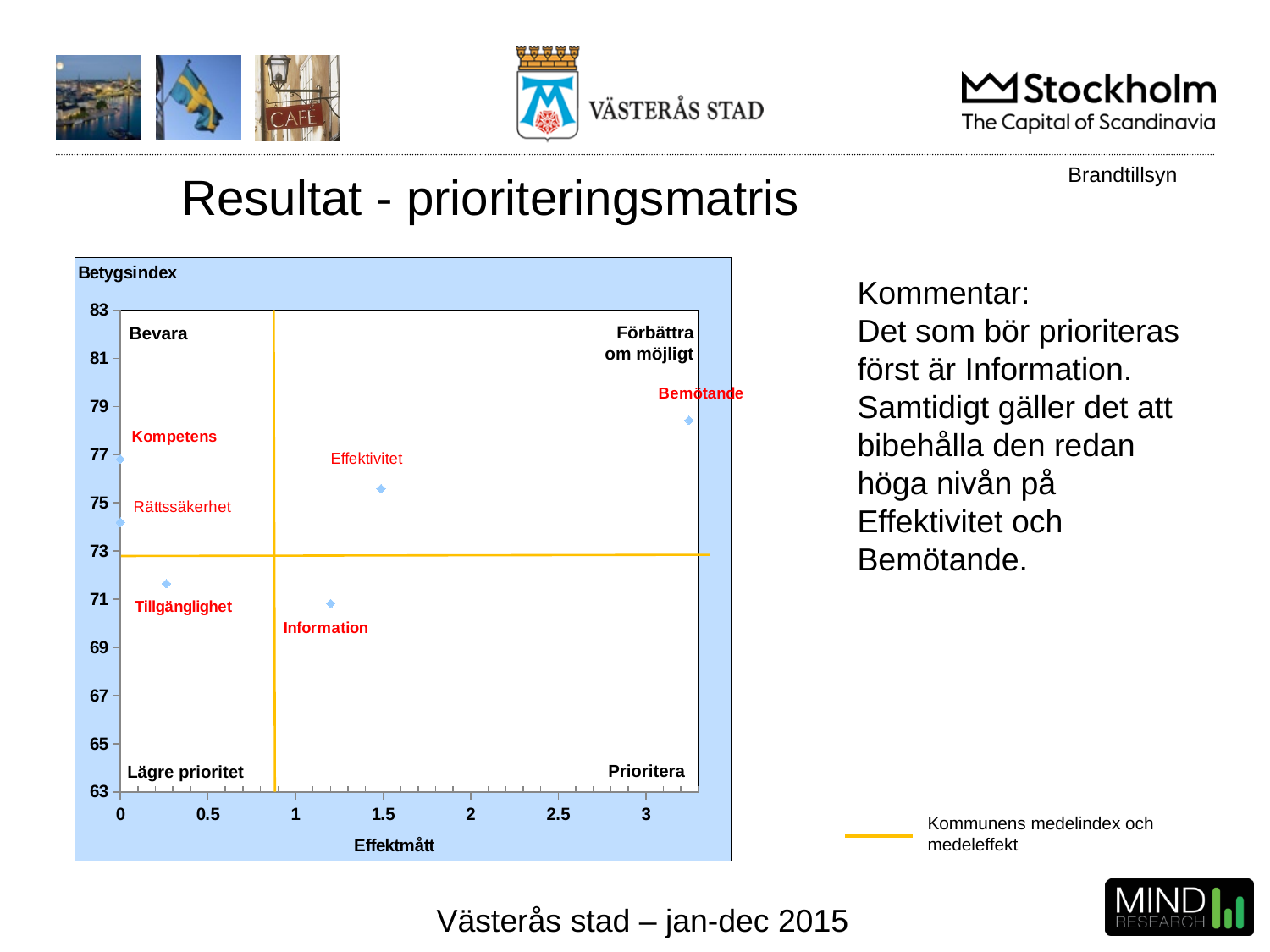
Is the Effektmått for Tillgänglighet greater or less than 0.5? less Is the Betygsindex for Bemötande greater or less than 77? greater Which has a higher Betygsindex, Kompetens or Rättssäkerhet? Kompetens What is the label of the horizontal axis of the chart? Effektmått Which point has the lowest Betygsindex? Information What kind of chart is shown on the slide? Scatter plot How many data points are plotted in the priority matrix? 6 Which point has the highest Betygsindex? Bemötande Is the Betygsindex for Information greater or less than 73? less Which has a higher Effektmått, Effektivitet or Information? Effektivitet Which point has the highest Effektmått? Bemötande